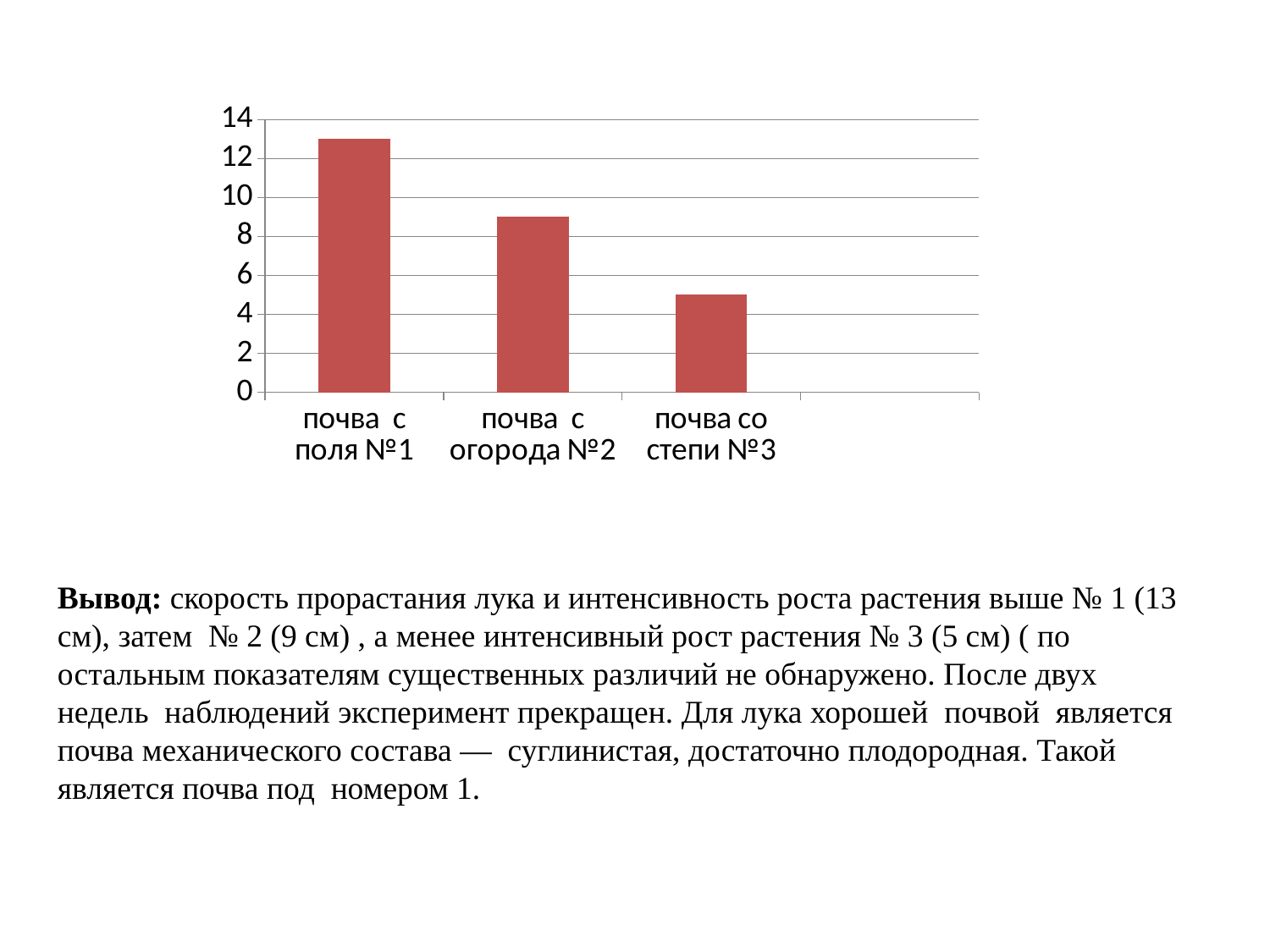
How many categories (bars) does the chart show? 3 What is the maximum value shown on the vertical axis? 14 Which is larger, the value for почва с огорода №2 or почва со степи №3? почва с огорода №2 Is the value for почва со степи №3 greater or less than 6? less Do the bar values rise or fall from left to right across the categories? fall Which category has the lowest bar? почва со степи №3 Is the value for почва с поля №1 greater or less than 12? greater According to the slide, what is the value (in cm) for почва со степи №3? 5 см What kind of chart is shown on the slide? bar chart According to the slide, what is the value (in cm) for почва с поля №1? 13 см Is the value for почва с огорода №2 greater or less than 10? less Which category has the highest bar? почва с поля №1